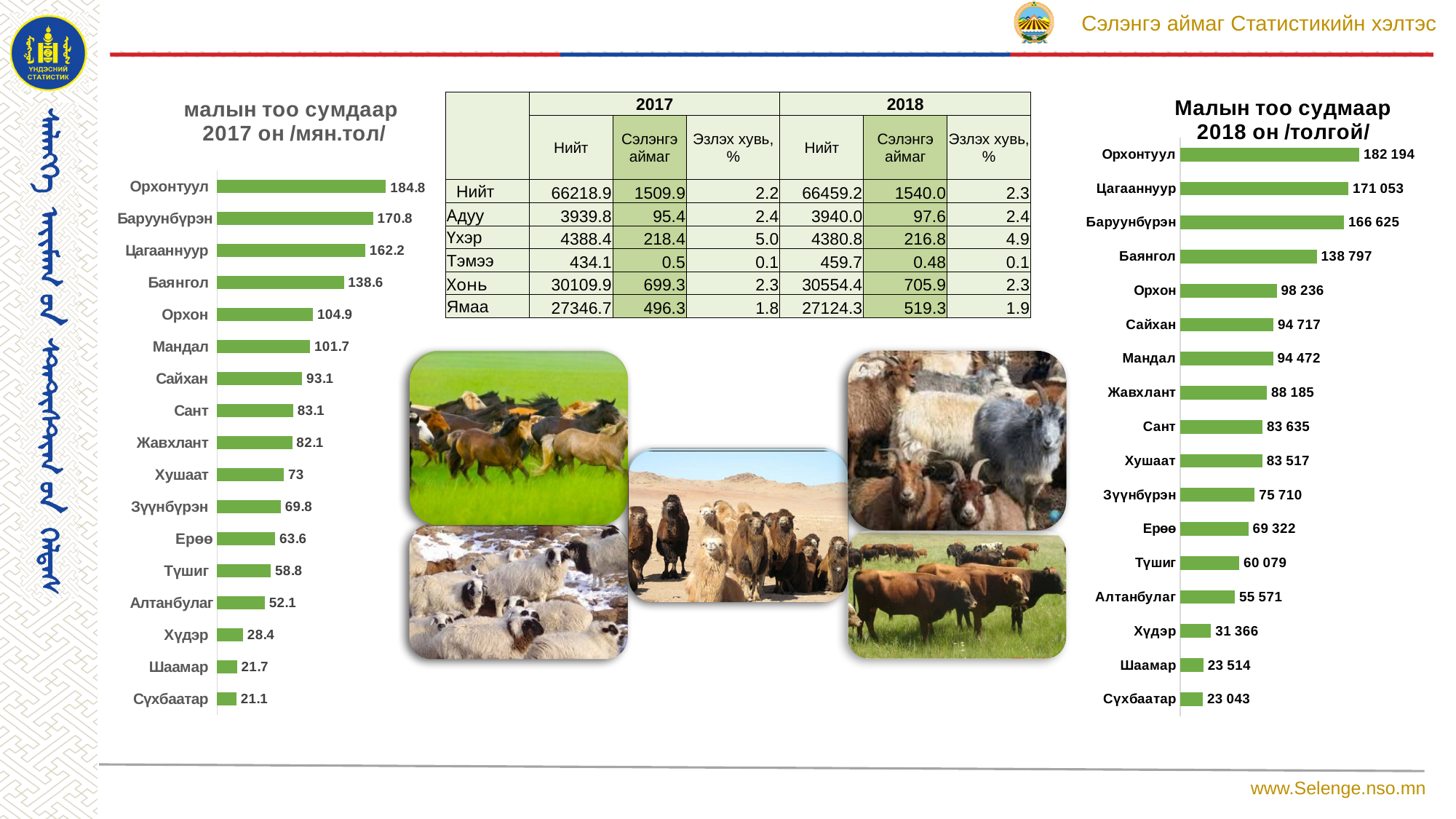
What kind of chart is the right chart titled 'Малын тоо судмаар 2018 он /толгой/'? bar chart In the left chart (2017), what is the difference between the values for Орхонтуул and Баруунбүрэн? 14 In the left chart (2017), what is the value for Сүхбаатар? 21.1 In the left chart (2017), which is larger: the value for Сайхан or the value for Сант? Сайхан What is the title of the right chart? Малын тоо судмаар 2018 он /толгой/ In the left chart titled 'малын тоо сумдаар 2017 он /мян.тол/', what is the value for Орхон? 104.9 In the right chart titled 'Малын тоо судмаар 2018 он /толгой/', what is the value for Баянгол? 138 797 In the right chart (2018), which category has the lowest value? Сүхбаатар In the right chart (2018), what is the value for Хүдэр? 31 366 How many categories are shown in the left chart (2017)? 17 In the right chart (2018), which is larger: the value for Цагааннуур or the value for Баруунбүрэн? Цагааннуур In the left chart (2017), which category has the highest value? Орхонтуул